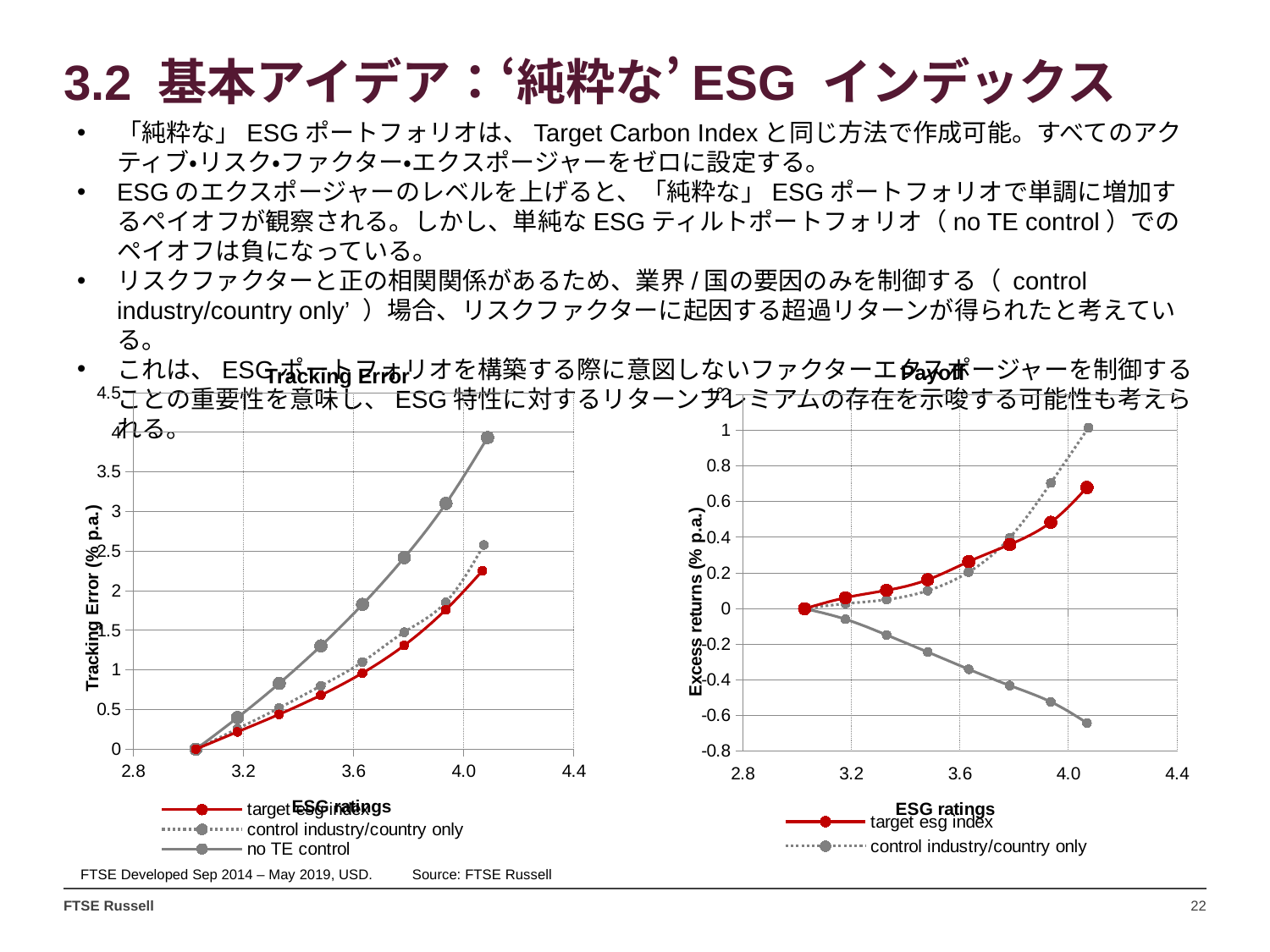
In the Tracking Error chart, does the tracking error of the target esg index rise or fall as ESG ratings increase? rise In the Tracking Error chart, is the tracking error of the target esg index at its highest ESG rating greater or less than 2? greater In the Tracking Error chart, is the tracking error of the no TE control series at its highest ESG rating greater or less than 3.5? greater In the Payoff chart, does the excess return of the target esg index rise or fall as ESG ratings increase? rise In the Payoff chart, is the excess return of the control industry/country only series at its highest ESG rating greater or less than 0.8? greater In the Payoff chart, which series has the higher excess return at the highest ESG rating: target esg index or control industry/country only? control industry/country only How many series does the legend of the Tracking Error chart list? 3 In the Tracking Error chart, which series reaches the highest tracking error at the highest ESG rating? no TE control What is the x-axis title of the Tracking Error chart? ESG ratings In the Tracking Error chart, which series has the lower tracking error at the highest ESG rating: target esg index or no TE control? target esg index What is the y-axis title of the Payoff chart? Excess returns (% p.a.) What kind of chart is the Tracking Error chart on the left? line chart